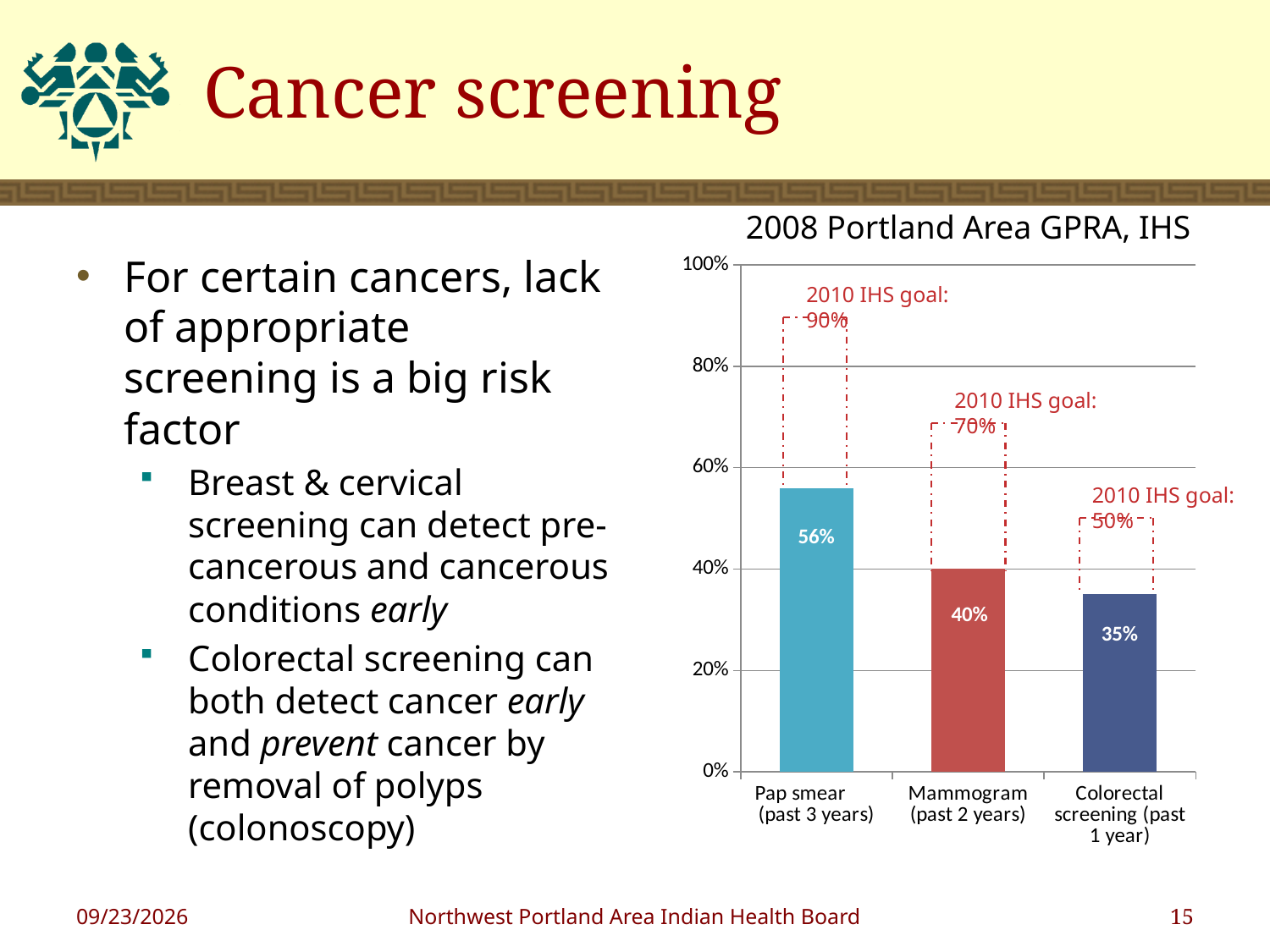
Which is larger, the value for Mammogram (past 2 years) or the value for Colorectal screening (past 1 year)? Mammogram (past 2 years) Which category has the highest value? Pap smear (past 3 years) What is the title of the chart? 2008 Portland Area GPRA, IHS What is the value for Pap smear (past 3 years)? 56% What is the value for Colorectal screening (past 1 year)? 35% What is the difference between the Mammogram value and the Colorectal screening value? 5% Is the value for Pap smear (past 3 years) greater or less than 60%? less How many categories are shown on the x axis? 3 Which category has the lowest value? Colorectal screening (past 1 year) What kind of chart is shown on the slide? bar chart What is the difference between the Pap smear value and the Mammogram value? 16% What is the value for Mammogram (past 2 years)? 40%